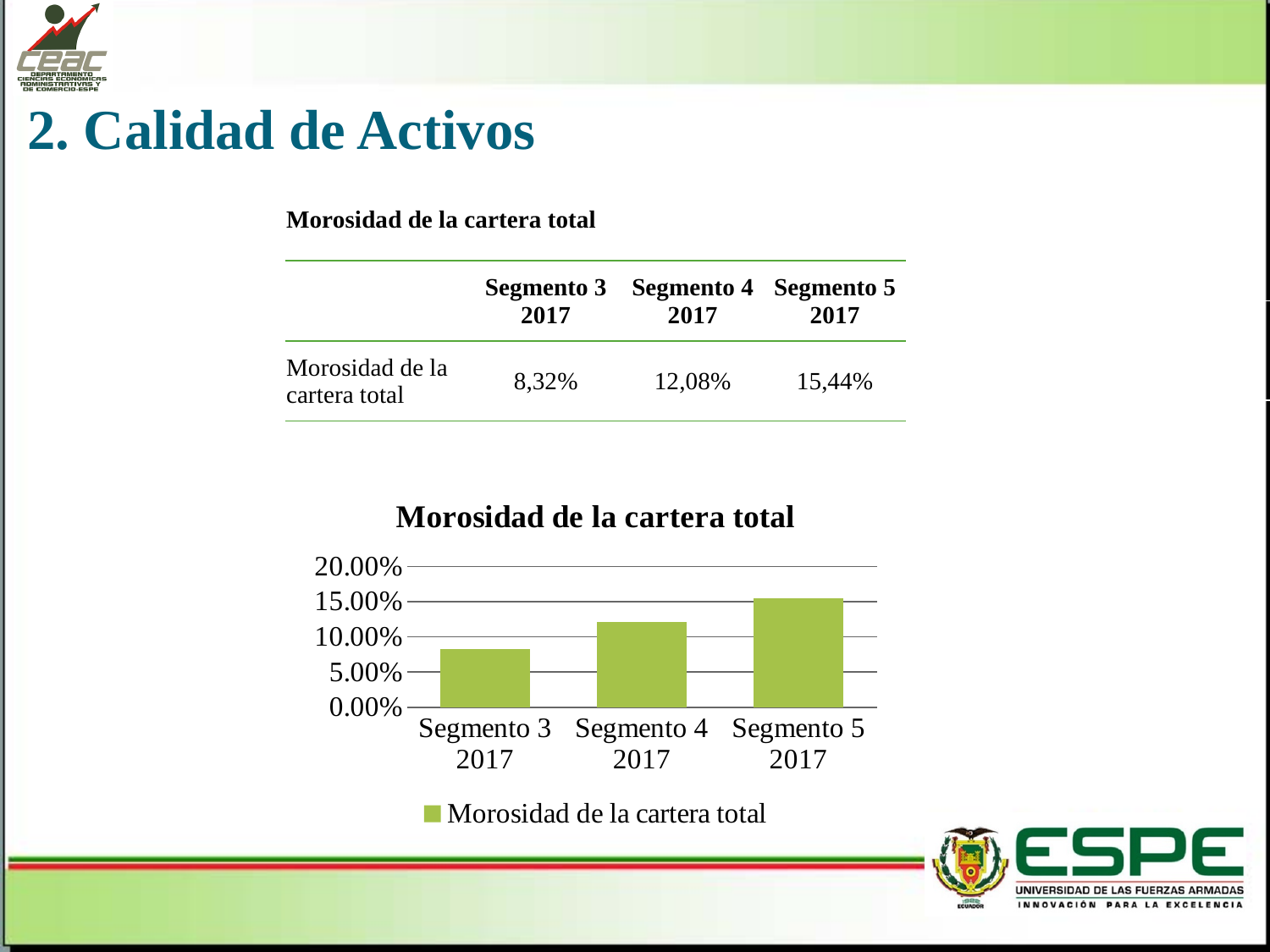
How many bars (categories) does the chart show? 3 According to the table on the slide, what is the Morosidad de la cartera total for Segmento 4 2017? 12,08% What is the title of the chart? Morosidad de la cartera total Which segment has the lowest Morosidad de la cartera total? Segmento 3 2017 What kind of chart is shown on the slide? bar chart Is the value for Segmento 5 2017 greater or less than 15.00%? greater Which is larger, the value for Segmento 4 2017 or Segmento 3 2017? Segmento 4 2017 Do the values rise or fall from Segmento 3 2017 to Segmento 5 2017? rise Which segment has the highest Morosidad de la cartera total? Segmento 5 2017 According to the table on the slide, what is the Morosidad de la cartera total for Segmento 5 2017? 15,44% Is the value for Segmento 3 2017 greater or less than 10.00%? less How many series does the chart legend list? 1